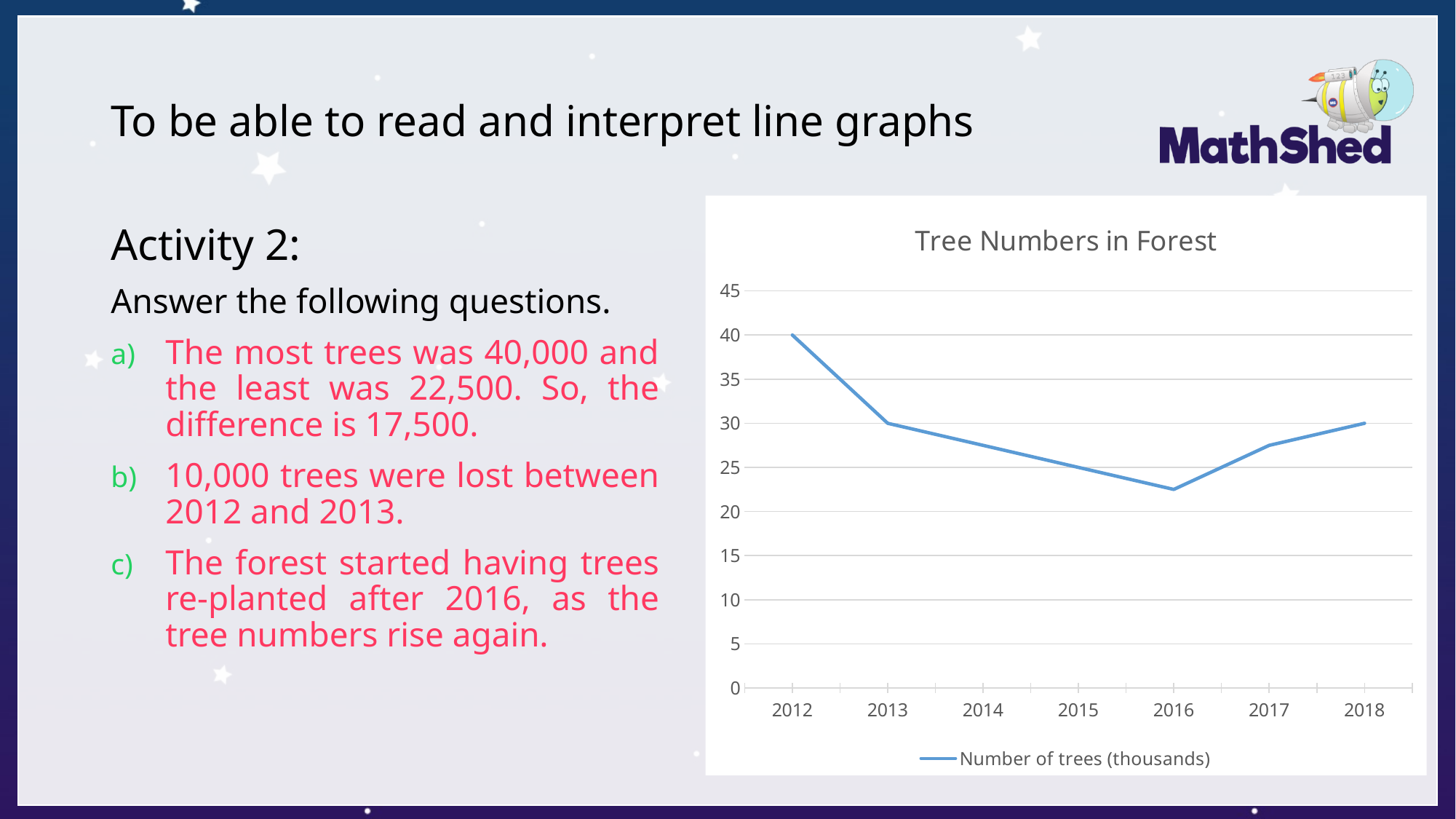
How many years are plotted on the x axis? 7 Is the value for 2014 greater or less than 30? less Which year has the highest number of trees? 2012 What is the value for 2018 on the Tree Numbers in Forest chart? 30 What kind of chart is shown on the slide? line chart What is the value for 2012 on the Tree Numbers in Forest chart? 40 Which year has the lowest number of trees? 2016 Do the values rise or fall from 2012 to 2016? fall What is the value for 2013 on the Tree Numbers in Forest chart? 30 What is the difference between the values for 2012 and 2013? 10 Is the value for 2016 greater or less than 25? less What is the value for 2015 on the Tree Numbers in Forest chart? 25